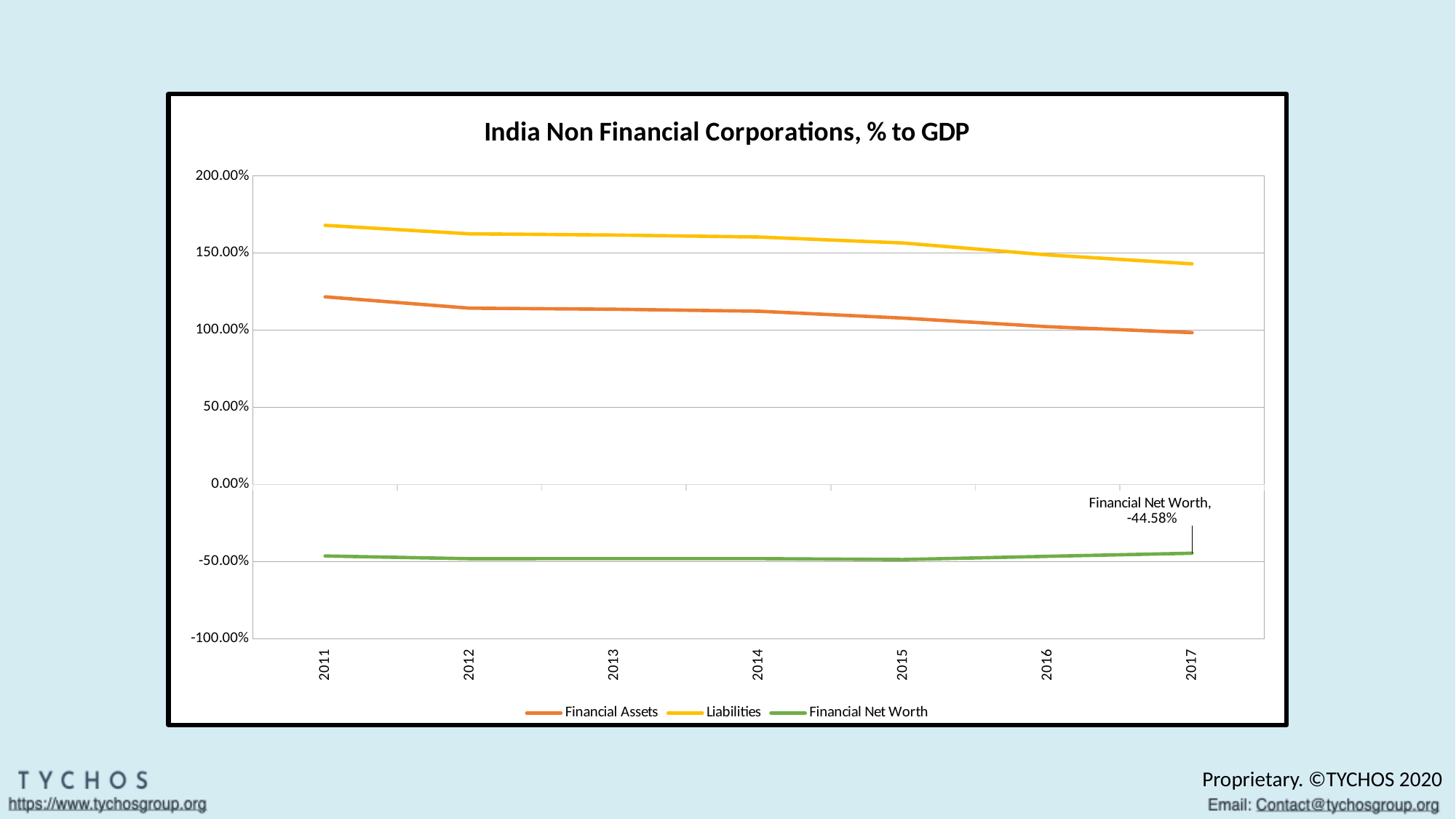
Do the Liabilities values rise or fall from 2011 to 2017? fall Which series has the lowest values across all years? Financial Net Worth Which is larger in 2014, Financial Assets or Liabilities? Liabilities Do the Financial Assets values rise or fall from 2011 to 2017? fall What is the value of Financial Net Worth in 2017? -44.58% What is the title of the chart? India Non Financial Corporations, % to GDP Is the value for Liabilities in 2011 greater or less than 150.00%? greater Is the value for Financial Assets in 2017 greater or less than 100.00%? less How many series does the legend list? 3 Which series has the highest values across all years? Liabilities How many years are shown on the x axis? 7 What kind of chart is shown on the slide? line chart